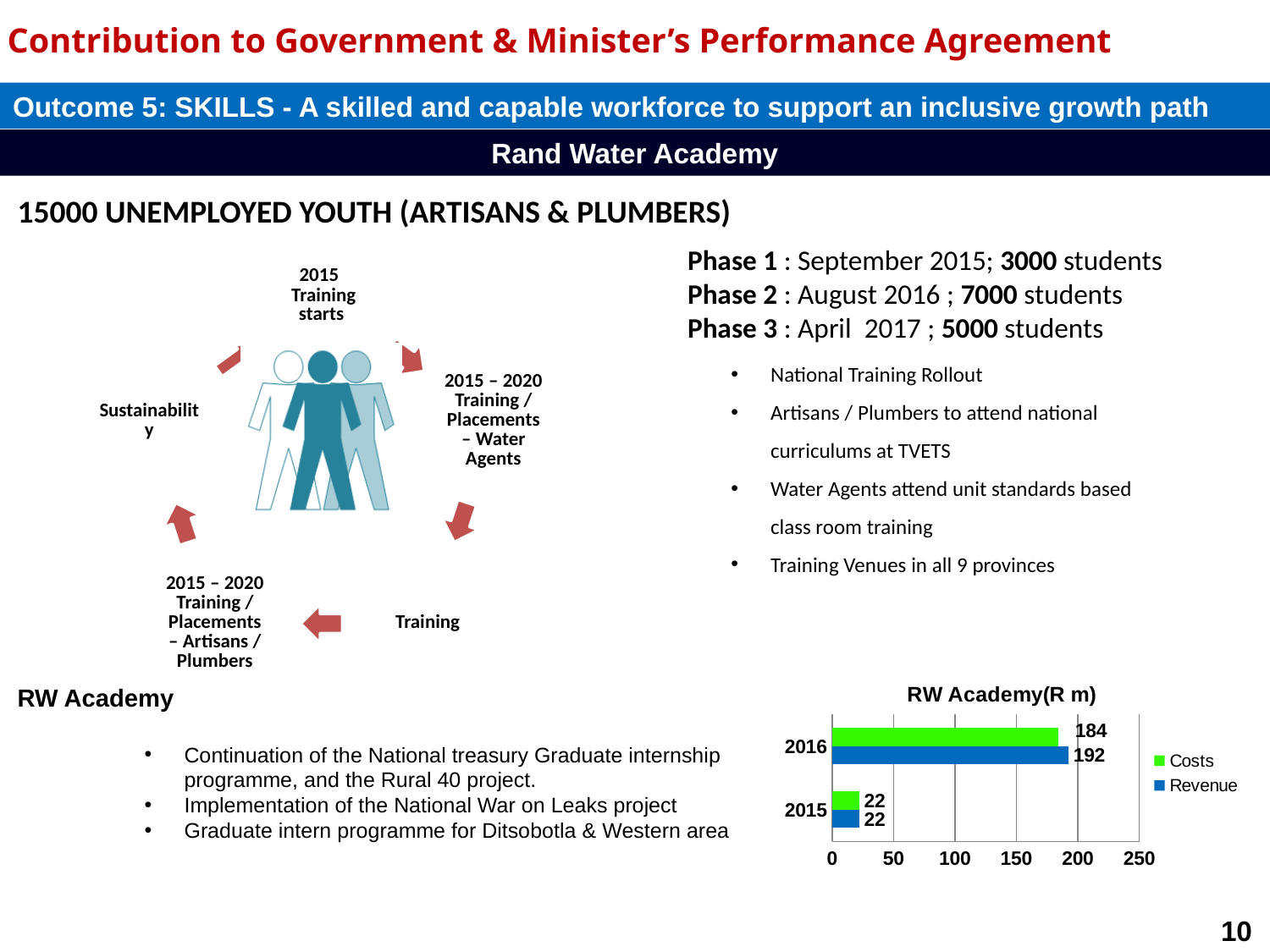
In the RW Academy(R m) chart, what is the Revenue value for 2015? 22 In the RW Academy(R m) chart, what is the Costs value for 2016? 184 In the RW Academy(R m) chart, what is the difference between Revenue and Costs for 2016? 8 How many series does the legend of the RW Academy(R m) chart list? 2 In the RW Academy(R m) chart, what is the Costs value for 2015? 22 How many years are shown on the RW Academy(R m) chart? 2 In the RW Academy(R m) chart, which year has the higher Revenue? 2016 What is the title of the bar chart on the slide? RW Academy(R m) In the RW Academy(R m) chart, what is the Revenue value for 2016? 192 In the RW Academy(R m) chart, which colour represents Costs? green What type of chart is the RW Academy(R m) chart? bar chart In the RW Academy(R m) chart, is the Costs value for 2016 greater or less than 150? greater